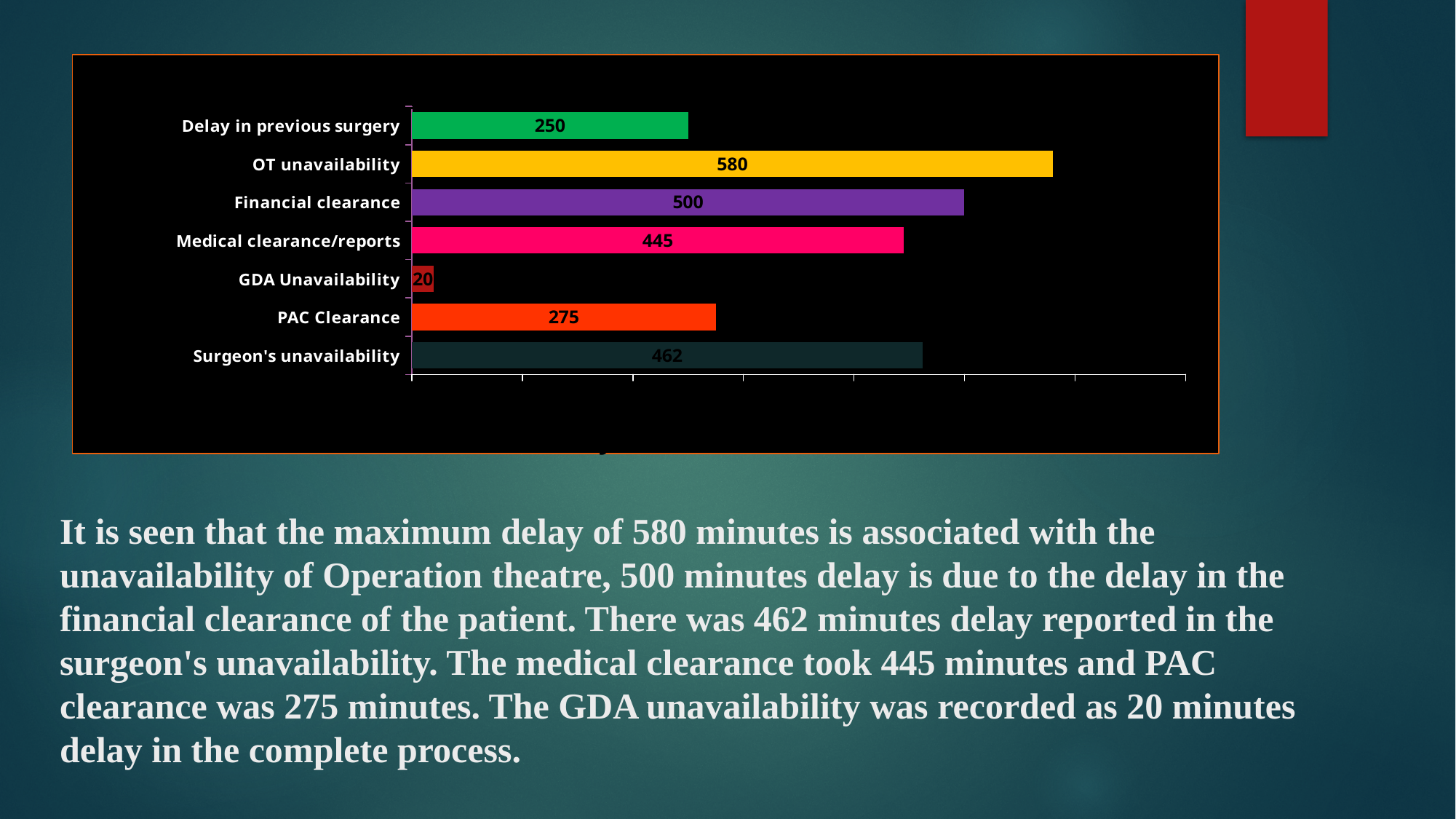
Which category has the lowest value? GDA Unavailability What is the value for Financial clearance? 500 What is the difference between the values for Medical clearance/reports and PAC Clearance? 170 Which category has the highest value? OT unavailability How many categories are shown in the chart? 7 Which is larger, the value for Delay in previous surgery or the value for PAC Clearance? PAC Clearance What kind of chart is shown on the slide? Bar chart What colour is the bar for OT unavailability? Yellow What is the difference between the values for OT unavailability and Financial clearance? 80 What is the value for GDA Unavailability? 20 What is the value for OT unavailability? 580 What is the value for Surgeon's unavailability? 462